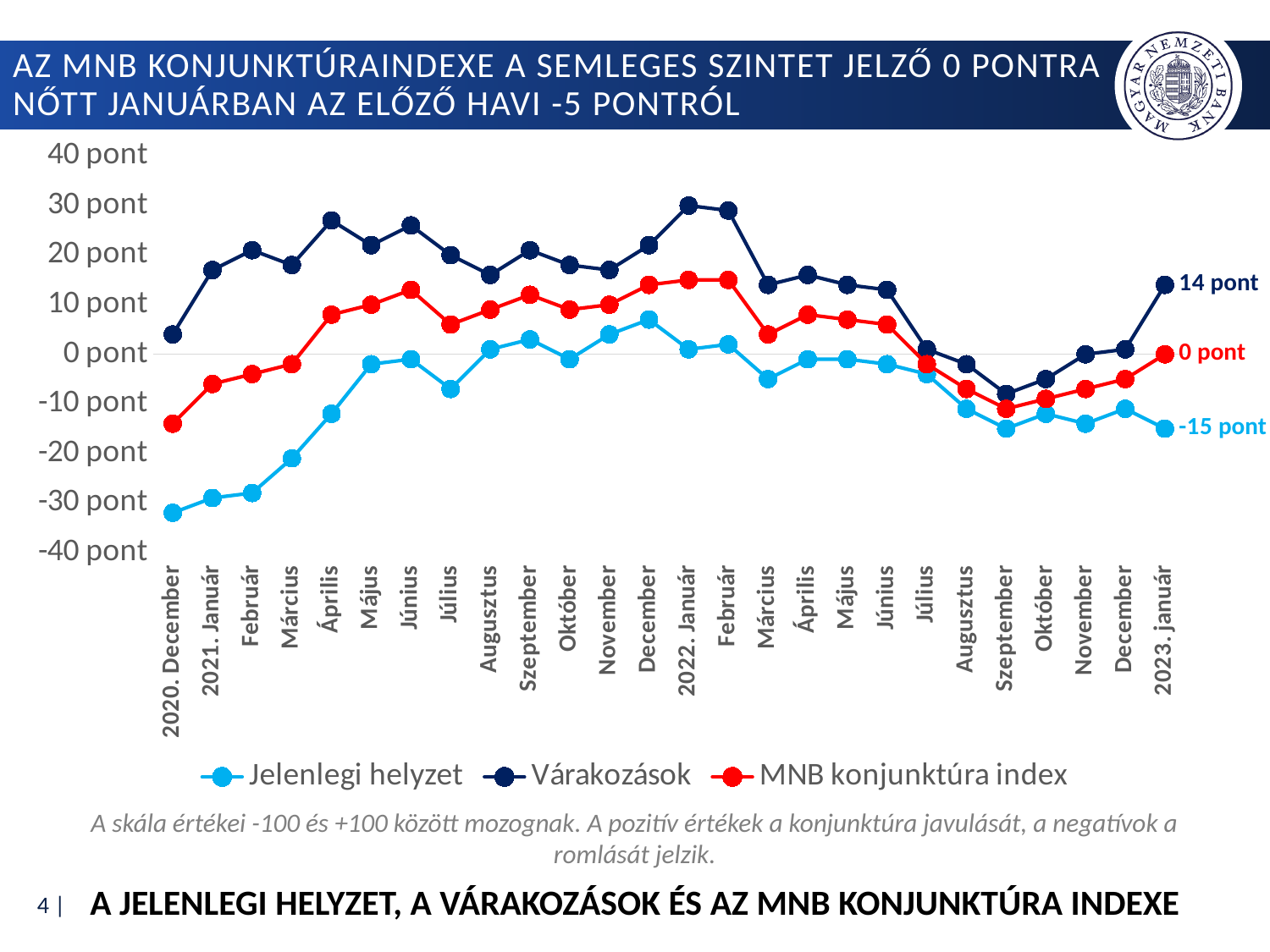
What is the value of Jelenlegi helyzet in 2023. január? -15 pont What is the difference between Várakozások and Jelenlegi helyzet in 2023. január? 29 pont In 2021. április, which is larger: Várakozások or Jelenlegi helyzet? Várakozások Is the value of Várakozások in 2022. január greater or less than 20 pont? greater How many months (data points) are plotted along the x axis? 26 Does the Jelenlegi helyzet series rise or fall from 2020. December to 2021. december? rise How many series does the legend list? 3 What type of chart is shown on the slide? line chart Is the value of Jelenlegi helyzet in 2020. December greater or less than -30 pont? less What is the value of Várakozások in 2023. január? 14 pont What is the value of the MNB konjunktúra index in 2023. január? 0 pont Which series has the highest value in 2023. január? Várakozások